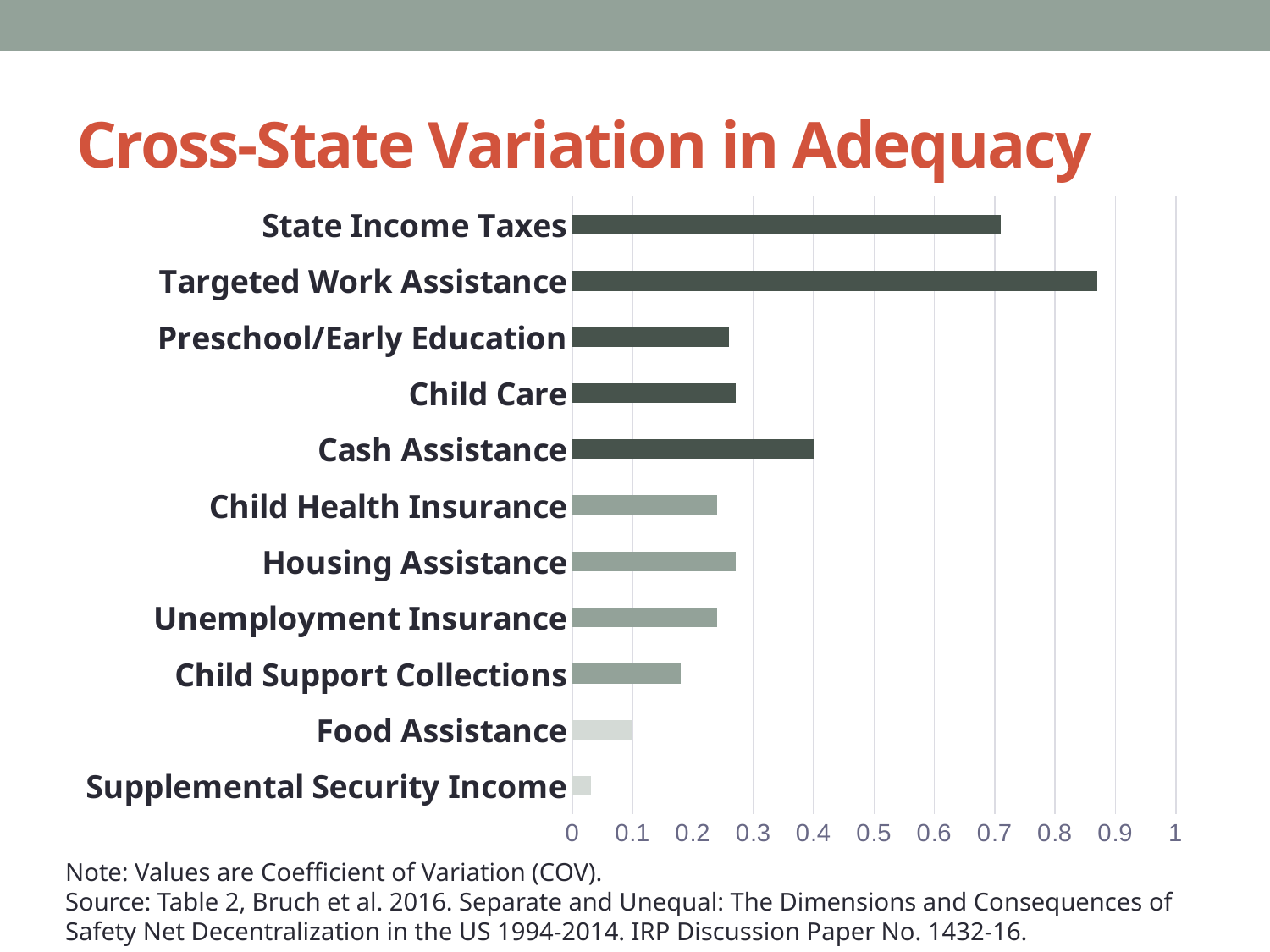
What kind of chart is shown on the slide? bar chart What is the title of the chart on the slide? Cross-State Variation in Adequacy Which category has the lowest value in the chart? Supplemental Security Income Which is larger, the value for Child Support Collections or the value for Food Assistance? Child Support Collections Is the value for Child Support Collections greater or less than 0.1? greater Is the value for Food Assistance greater or less than 0.2? less Is the value for Targeted Work Assistance greater or less than 0.8? greater Which category has the highest value in the chart? Targeted Work Assistance Which is larger, the value for State Income Taxes or the value for Cash Assistance? State Income Taxes How many categories are plotted in the chart? 11